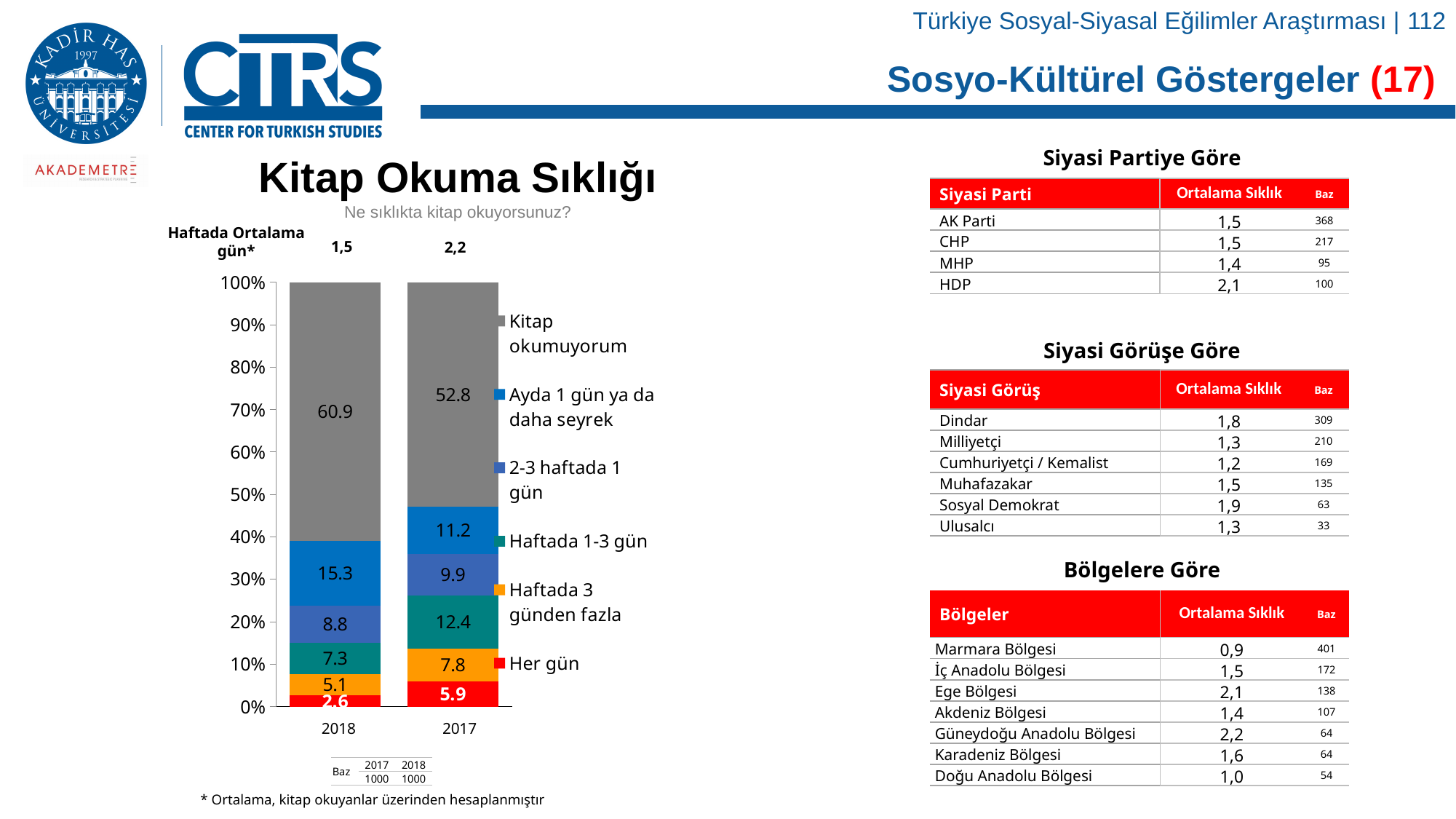
In the Kitap Okuma Sıklığı chart, which year has the larger 'Her gün' value, 2018 or 2017? 2017 In the Kitap Okuma Sıklığı chart, what is the value for 'Kitap okumuyorum' in 2018? 60.9 In the Kitap Okuma Sıklığı chart, which category has the smallest share in the 2018 bar? Her gün In the Kitap Okuma Sıklığı chart, what is the value for 'Haftada 1-3 gün' in 2017? 12.4 In the Kitap Okuma Sıklığı chart, what is the value for 'Her gün' in 2017? 5.9 How many bars (years) are shown in the Kitap Okuma Sıklığı chart? 2 In the Kitap Okuma Sıklığı chart, which category has the largest share in the 2018 bar? Kitap okumuyorum In the Kitap Okuma Sıklığı chart, what is the difference between the 'Kitap okumuyorum' values for 2018 and 2017? 8.1 What kind of chart is the Kitap Okuma Sıklığı chart? Stacked bar chart In the Kitap Okuma Sıklığı chart, what is the difference between the 'Haftada 1-3 gün' values for 2017 and 2018? 5.1 How many series does the legend of the Kitap Okuma Sıklığı chart list? 6 In the Kitap Okuma Sıklığı chart, what is the value for 'Ayda 1 gün ya da daha seyrek' in 2018? 15.3